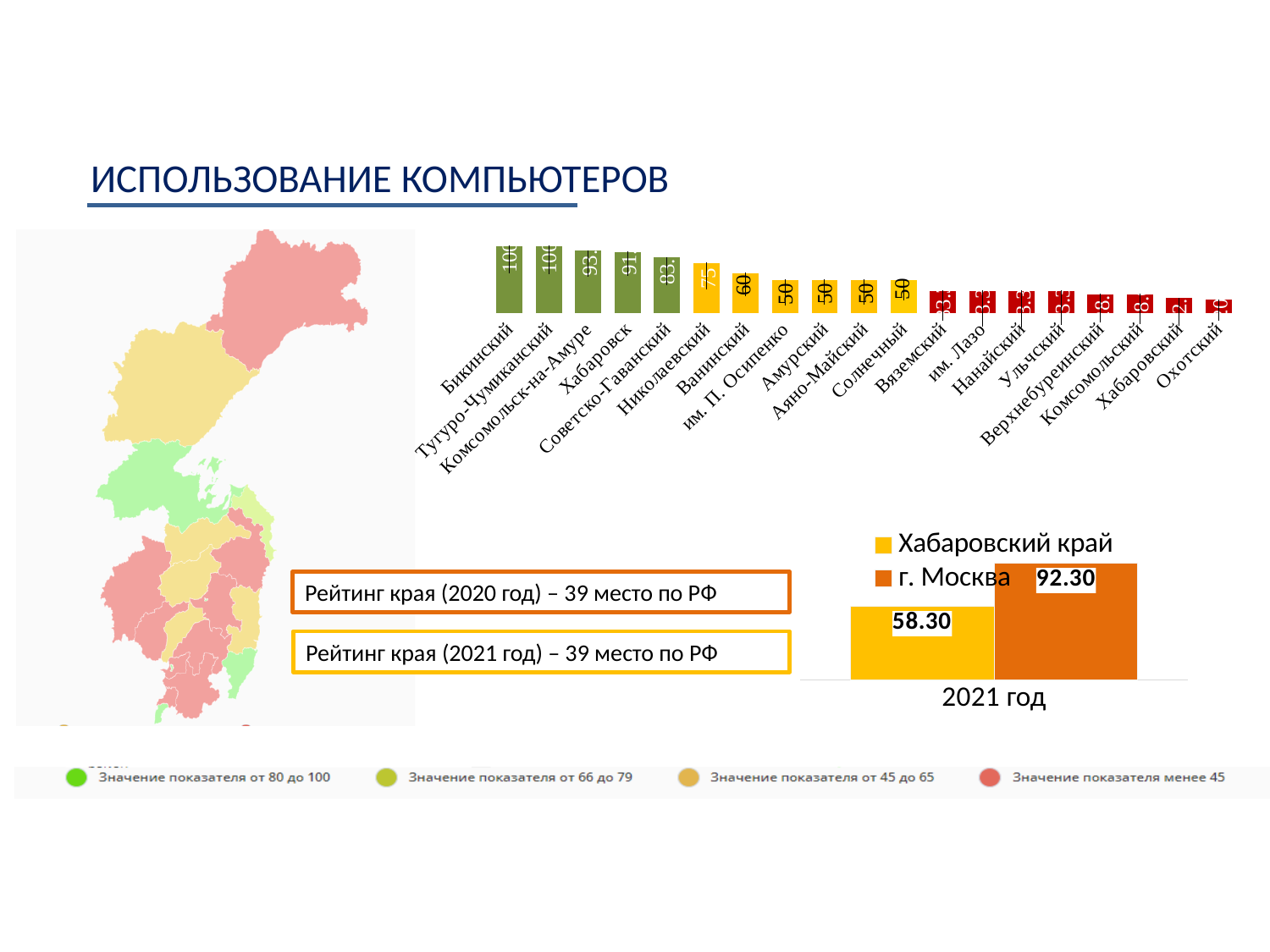
In the top bar chart, which district has the lowest value? Охотский In the top bar chart, what is the value for Бикинский? 100 In the top bar chart, what is the value for Николаевский? 75 In the bottom chart for 2021 год, what is the value for Хабаровский край? 58.30 In the bottom chart for 2021 год, what is the difference between г. Москва and Хабаровский край? 34.00 How many series does the legend of the bottom chart list? 2 In the bottom chart for 2021 год, what is the value for г. Москва? 92.30 How many districts are shown in the top bar chart? 19 In the top bar chart, which is larger: the value for Хабаровск or the value for Николаевский? Хабаровск In the top bar chart, what is the value for Ванинский? 60 In the top bar chart, do the values rise or fall from left to right? fall